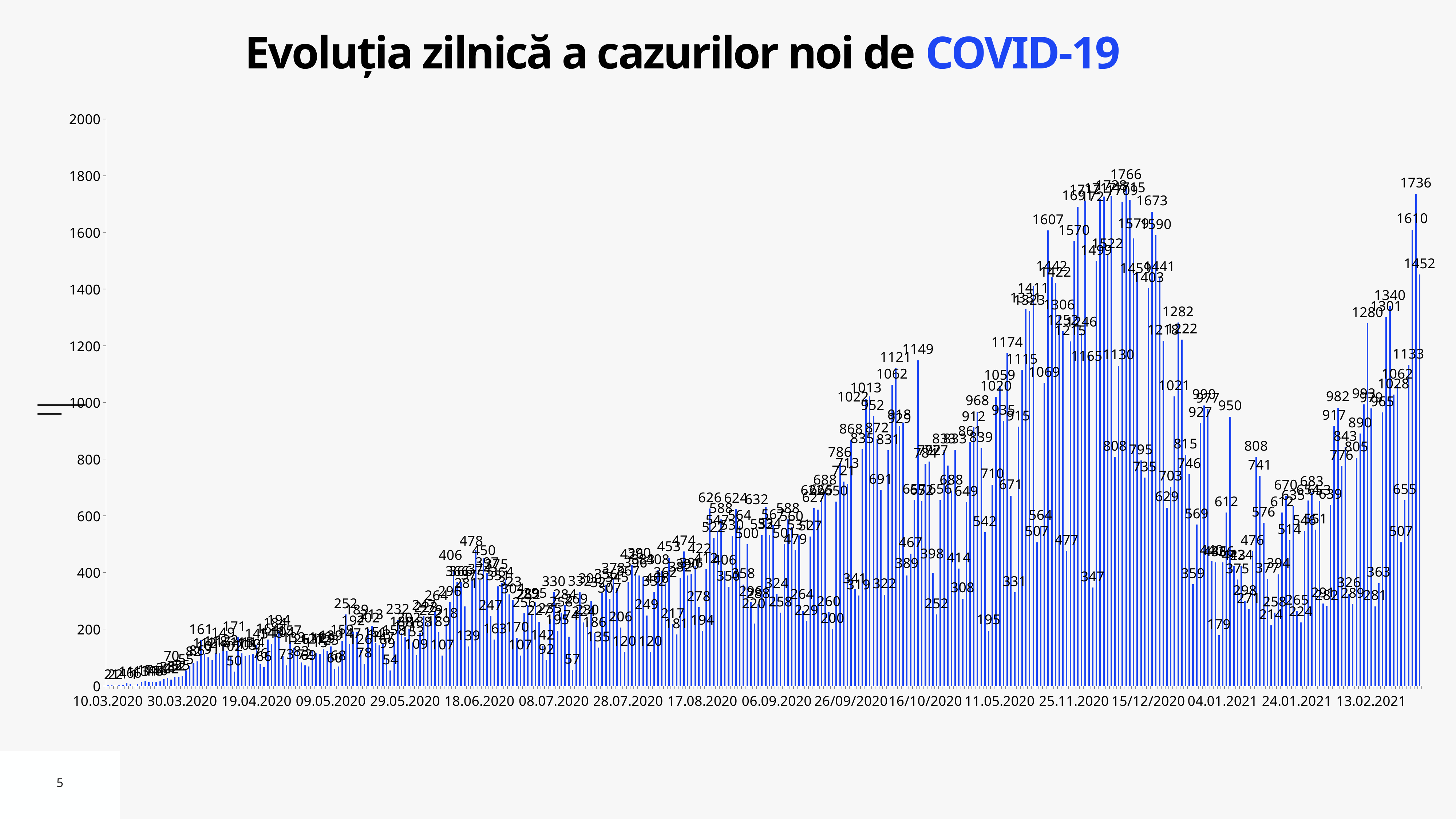
What is the highest value on the vertical axis? 2000 What is the highest value labeled near 18.06.2020? 478 What is the title of the chart? Evoluția zilnică a cazurilor noi de COVID-19 What is the highest value labeled on the chart? 1766 What is the difference between the highest labeled value (1766) and the highest value after 13.02.2021 (1736)? 30 What is the difference between the bars labeled 1736 and 1610 at the right end of the chart? 126 Do the values rise or fall from 10.03.2020 to 30.03.2020? rise Which is larger, the bar labeled 1607 or the bar labeled 1673? 1673 Is the value of the first bar (10.03.2020) greater or less than 200? less What kind of chart is shown on the slide? bar chart What is the highest value labeled in the section after 13.02.2021? 1736 What is the lowest value labeled near 08.07.2020? 57